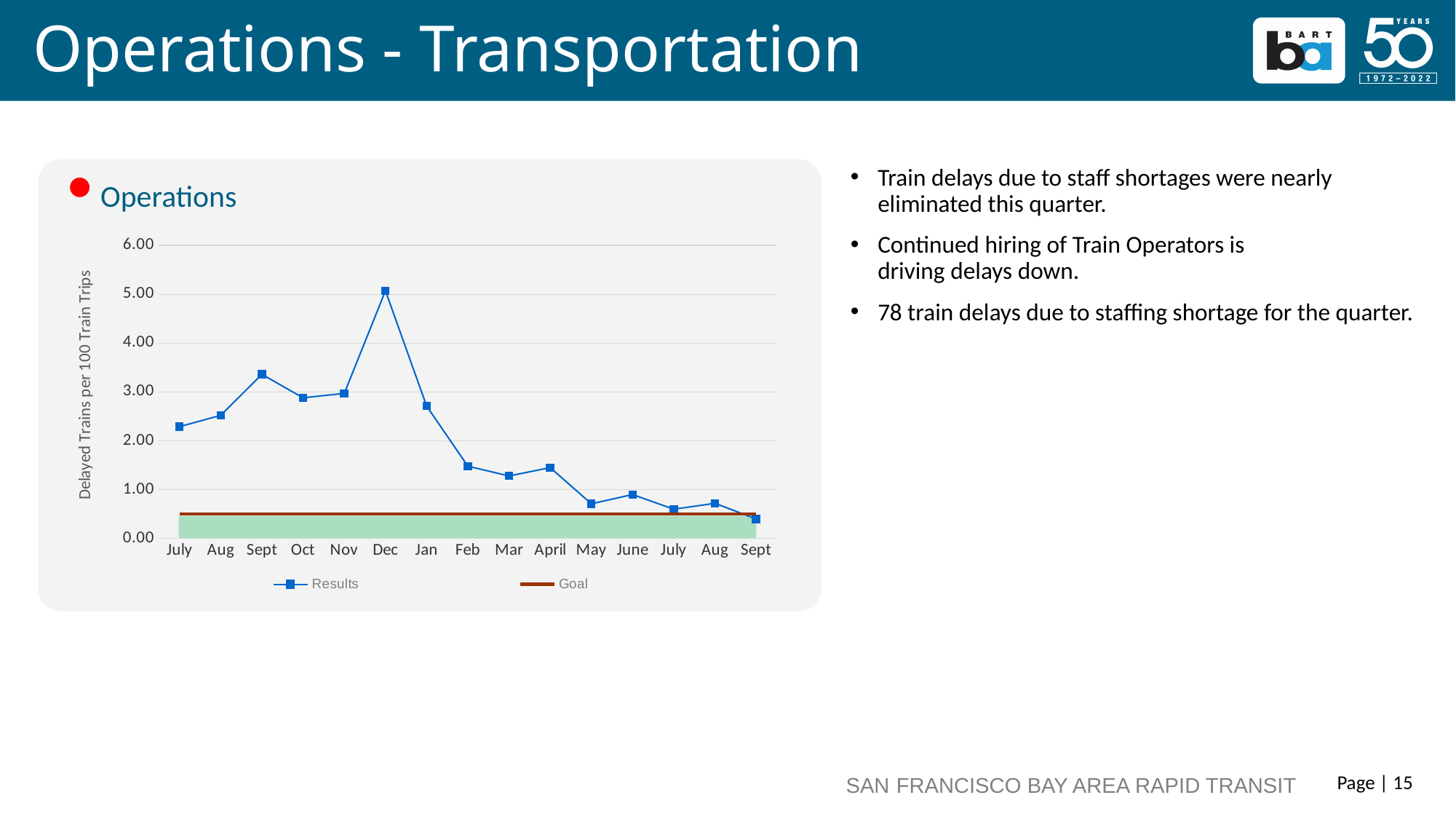
Is the Results value for Jan greater or less than 3.00? less In which month does the Results series reach its highest value? Dec How many series does the chart legend list? 2 Is the Results value for Feb greater or less than 2.00? less Is the Results value for May greater or less than 1.00? less Which is larger, the Results value for Dec or for Jan? Dec How many months are plotted along the x axis of the chart? 15 Do the Results values rise or fall from Dec to the final Sept? fall What is the title of the chart's vertical axis? Delayed Trains per 100 Train Trips What kind of chart is shown on the slide? line chart In which month does the Results series reach its lowest value? Sept (the last month)